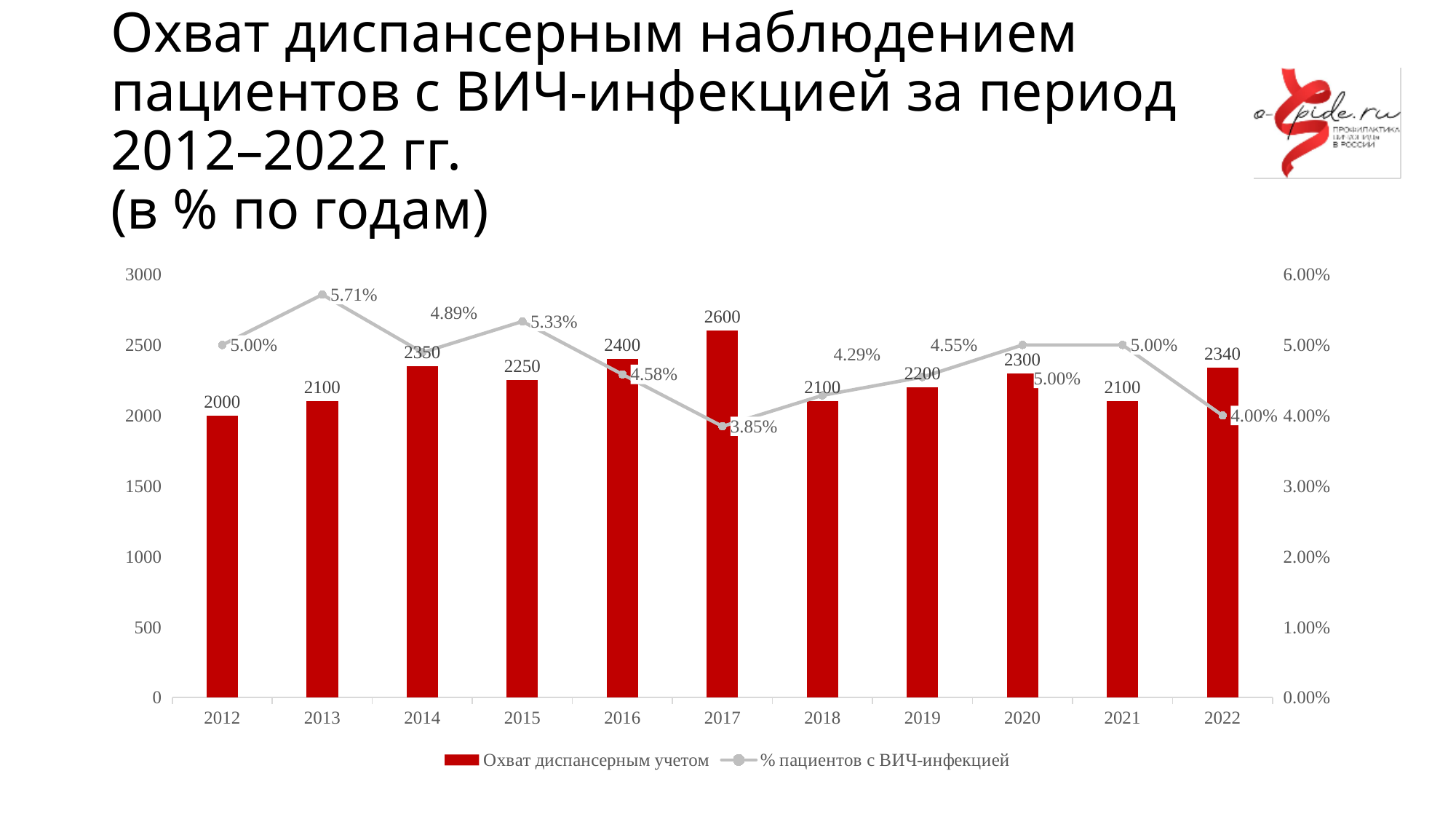
Which is larger, the Охват диспансерным учетом value for 2014 or for 2015? 2014 What is the value of % пациентов с ВИЧ-инфекцией for 2017? 3.85% What is the value of Охват диспансерным учетом for 2017? 2600 What is the value of % пациентов с ВИЧ-инфекцией for 2013? 5.71% How many years are shown on the x axis? 11 What is the value of Охват диспансерным учетом for 2022? 2340 Which year has the highest value of Охват диспансерным учетом? 2017 What is the difference between the Охват диспансерным учетом values for 2017 and 2012? 600 How many series does the legend list? 2 Which year has the lowest value of % пациентов с ВИЧ-инфекцией? 2017 What kind of chart is shown on the slide? Combined bar and line chart Which year has the lowest value of Охват диспансерным учетом? 2012